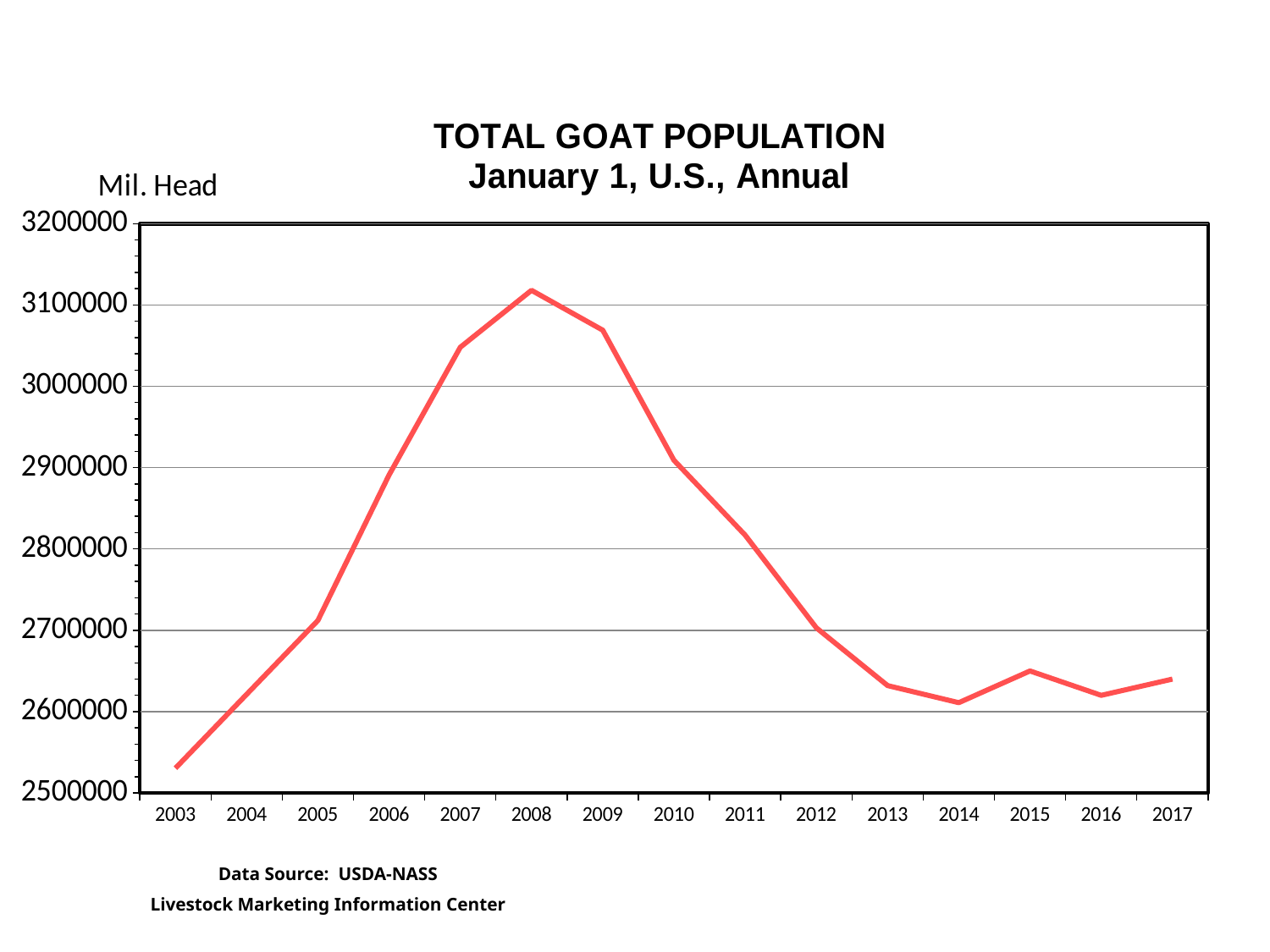
Is the value for 2007 greater or less than 3000000? greater How many years are plotted on the x axis? 15 In which year is the total goat population lowest? 2003 Is the value for 2003 greater or less than 2600000? less Does the goat population rise or fall from 2003 to 2008? rise In which year does the total goat population reach its highest value? 2008 Which year has the larger goat population, 2007 or 2011? 2007 Is the value for 2013 greater or less than 2700000? less What unit label is shown above the y axis? Mil. Head What kind of chart is shown on the slide? line chart Does the goat population rise or fall from 2008 to 2014? fall